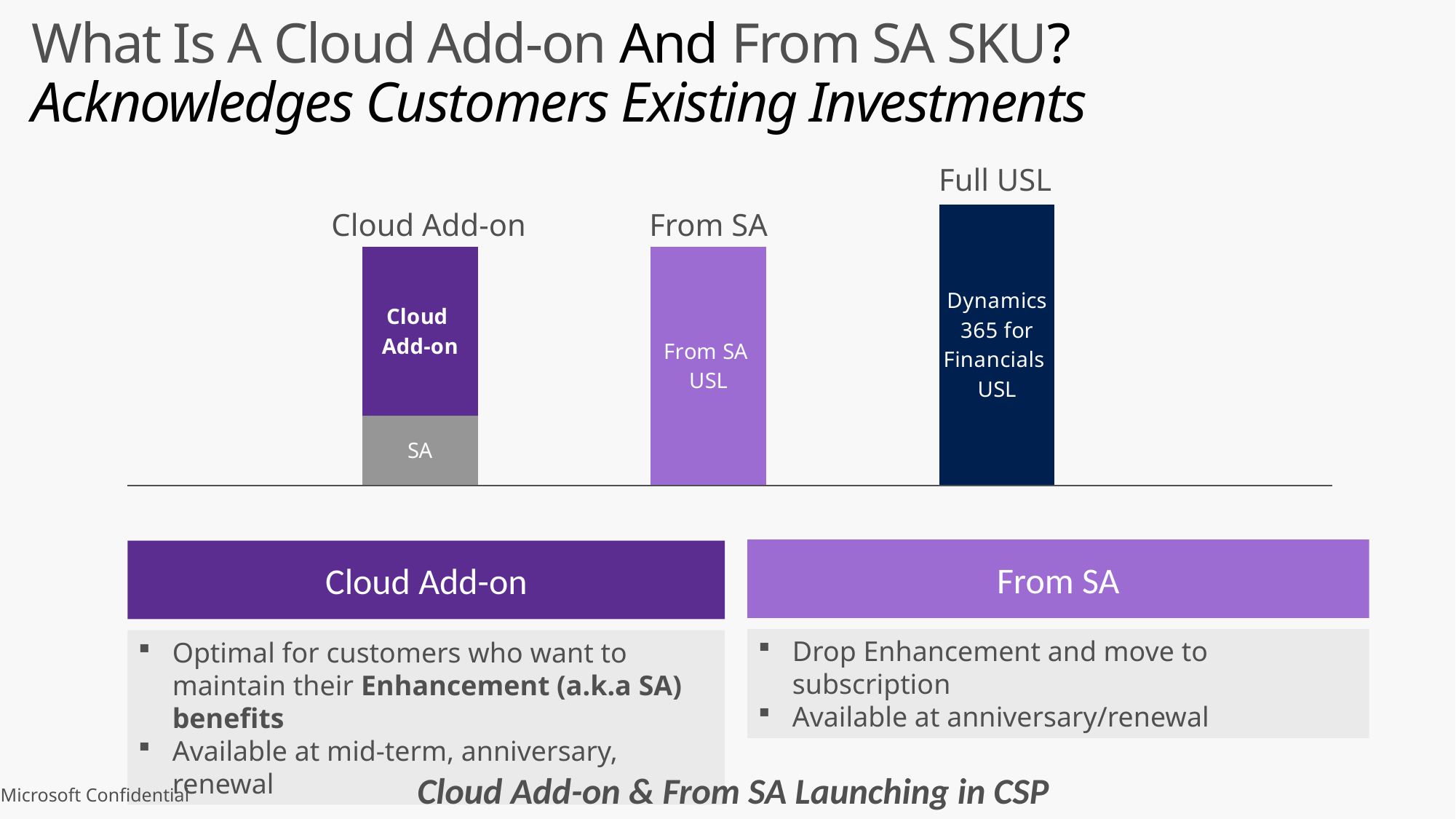
Which bar is taller, Full USL or Cloud Add-on? Full USL Which bar in the chart is the tallest? Full USL What label is printed inside the Full USL bar? Dynamics 365 for Financials USL What is the label of the bottom segment of the Cloud Add-on bar? SA Which bar in the chart is made up of more than one segment? Cloud Add-on Which bar is taller, Full USL or From SA? Full USL What kind of chart is shown on the slide? bar chart How many segments make up the Cloud Add-on bar? 2 How many bars are shown in the chart? 3